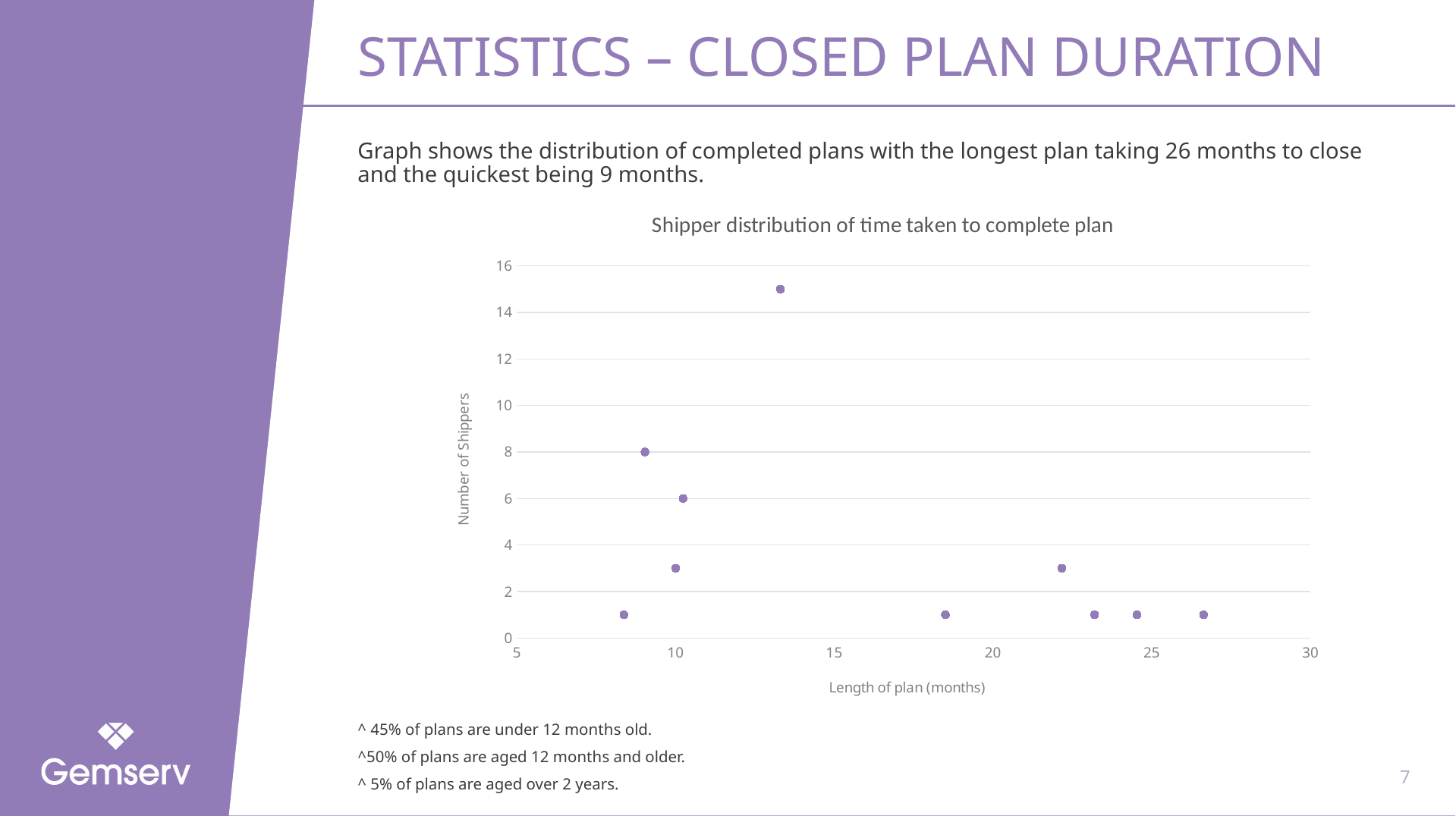
What is the highest value shown on the vertical axis of the chart? 16 How many points on the chart have a number of shippers below 2? 5 Do the points with the longest plan lengths (over 20 months) have more or fewer shippers than the point at about 13 months? fewer What is the title of the chart? Shipper distribution of time taken to complete plan Is the number of shippers for the point at about 22 months greater or less than 4? less How many data points are plotted on the chart? 10 How many points on the chart have a number of shippers greater than 10? 1 Which has more shippers: the point at about 13 months or the point at about 9 months? the point at about 13 months Is the number of shippers for the highest point on the chart greater or less than 14? greater Is the number of shippers for the point at about 9 months greater or less than 6? greater What is the label of the vertical axis of the chart? Number of Shippers What kind of chart is shown on the slide? scatter chart